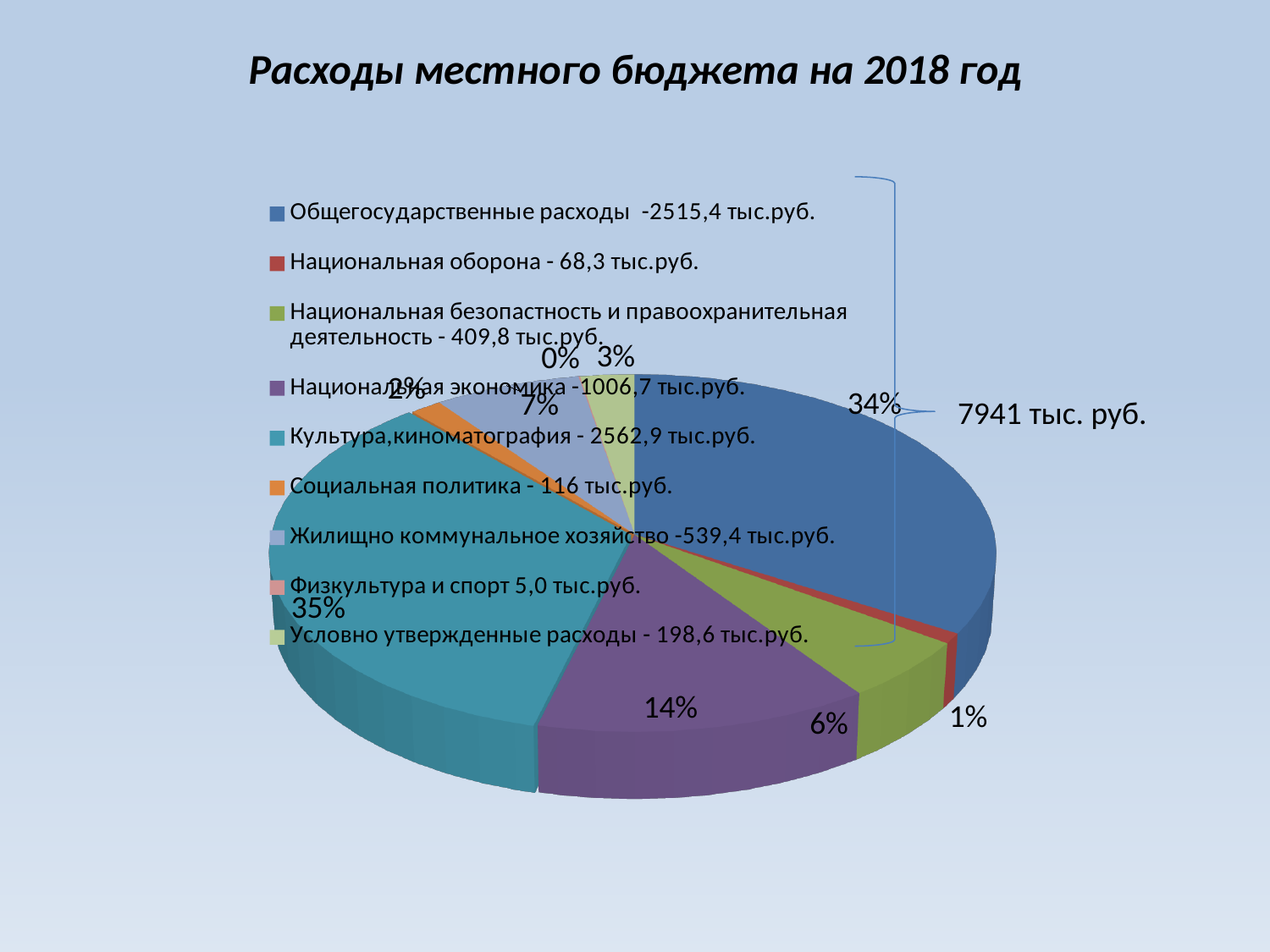
What kind of chart is shown on the slide? pie chart Which category has the largest share of the pie? Культура,киноматография How many categories does the legend of the pie chart list? 9 What is the value given in the legend for Социальная политика? 116 тыс.руб. Which is larger: the value for Жилищно коммунальное хозяйство or for Национальная безопастность и правоохранительная деятельность? Жилищно коммунальное хозяйство What is the difference between the values for Общегосударственные расходы and Национальная экономика? 1508,7 тыс.руб. Which category has the smallest share of the pie? Физкультура и спорт What share of the pie does Условно утвержденные расходы take? 3% What is the value given in the legend for Национальная оборона? 68,3 тыс.руб. What total amount is shown next to the pie chart? 7941 тыс. руб. What share of the pie does Национальная экономика take? 14% What share of the pie does Культура,киноматография take? 35%